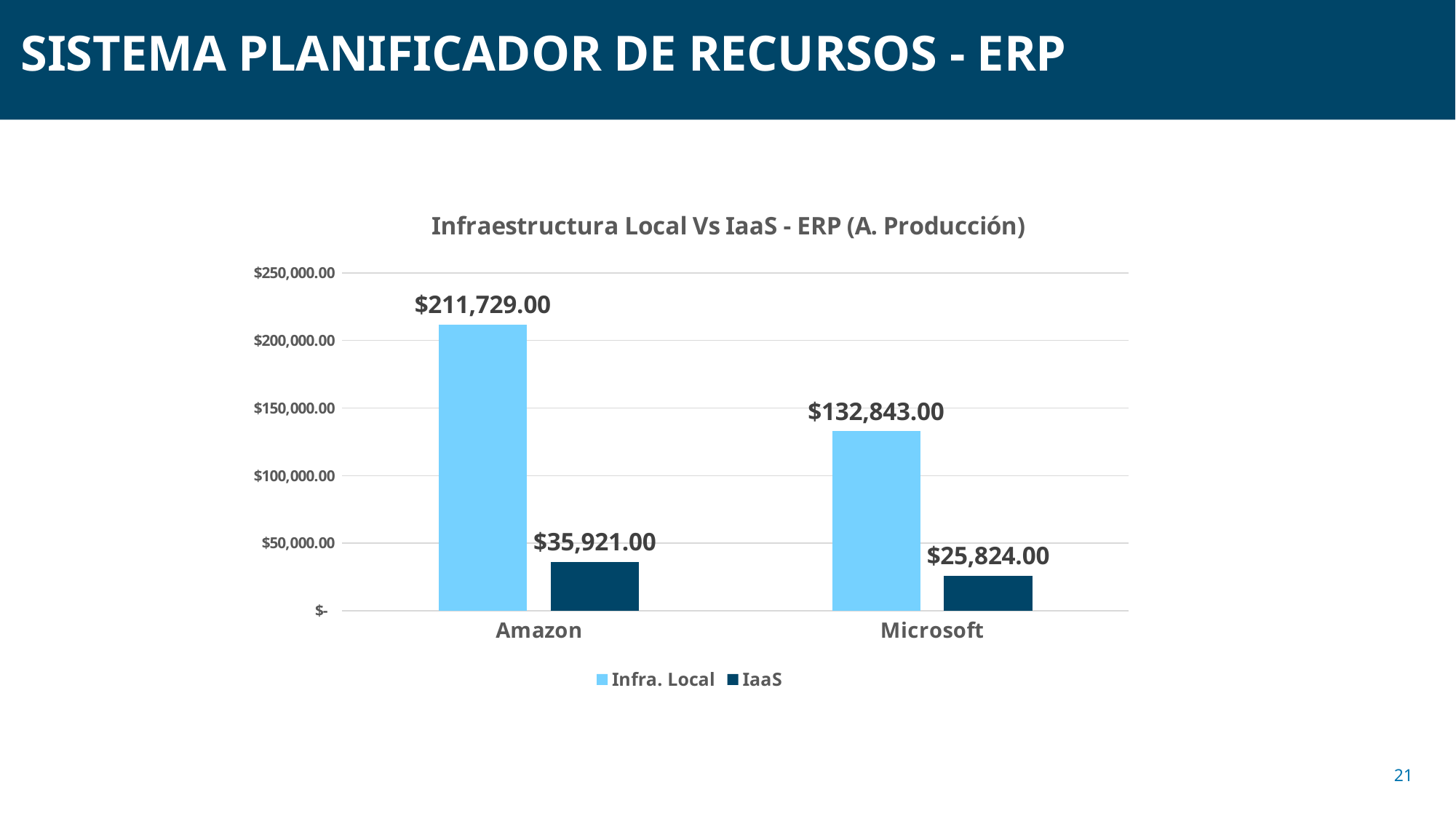
What is the difference between the Infra. Local and IaaS values for Amazon? $175,808.00 What is the IaaS value for Microsoft? $25,824.00 Which category has the lowest IaaS value? Microsoft How many series does the legend list? 2 How many categories are shown on the x axis? 2 What is the Infra. Local value for Amazon? $211,729.00 Which is larger for Microsoft, Infra. Local or IaaS? Infra. Local What type of chart is shown on the slide? Bar chart What is the Infra. Local value for Microsoft? $132,843.00 What is the difference between the Infra. Local values for Amazon and Microsoft? $78,886.00 Which category has the highest Infra. Local value? Amazon What is the IaaS value for Amazon? $35,921.00